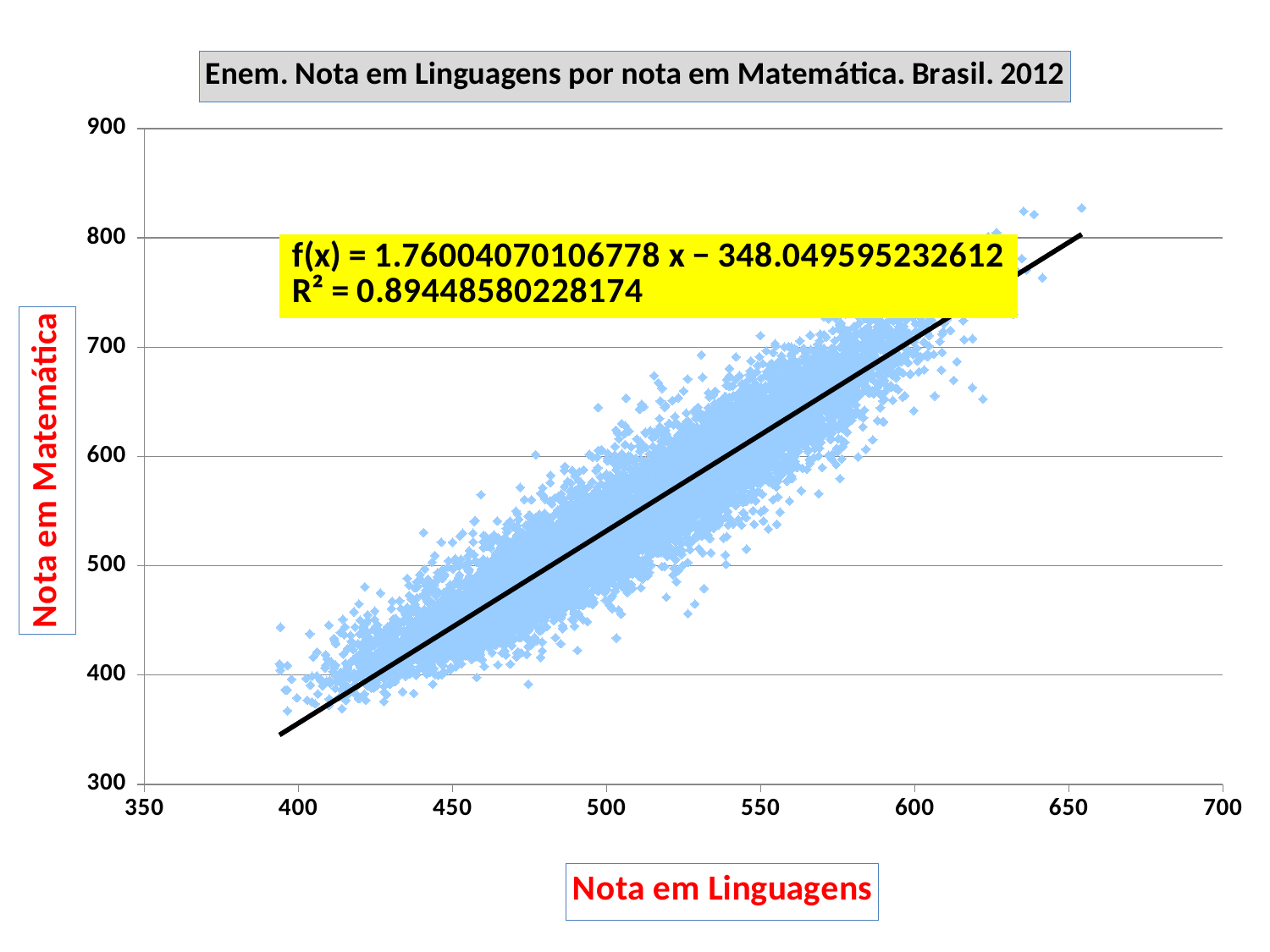
What is the intercept of the fitted line f(x) printed on the chart? −348.049595232612 Is the fitted trend line's value at a Nota em Linguagens of 450 greater or less than 500? less What is the title of the chart? Enem. Nota em Linguagens por nota em Matemática. Brasil. 2012 What kind of chart is shown on the slide? Scatter chart What is the R² value printed on the chart? 0.89448580228174 As the Nota em Linguagens increases along the x axis, does the Nota em Matemática tend to rise or fall? Rise What is the slope of the fitted line f(x) printed on the chart? 1.76004070106778 Is the fitted trend line's value at a Nota em Linguagens of 550 greater or less than 600? greater Is the fitted trend line's value at a Nota em Linguagens of 400 greater or less than 400? less What is the label of the vertical axis? Nota em Matemática